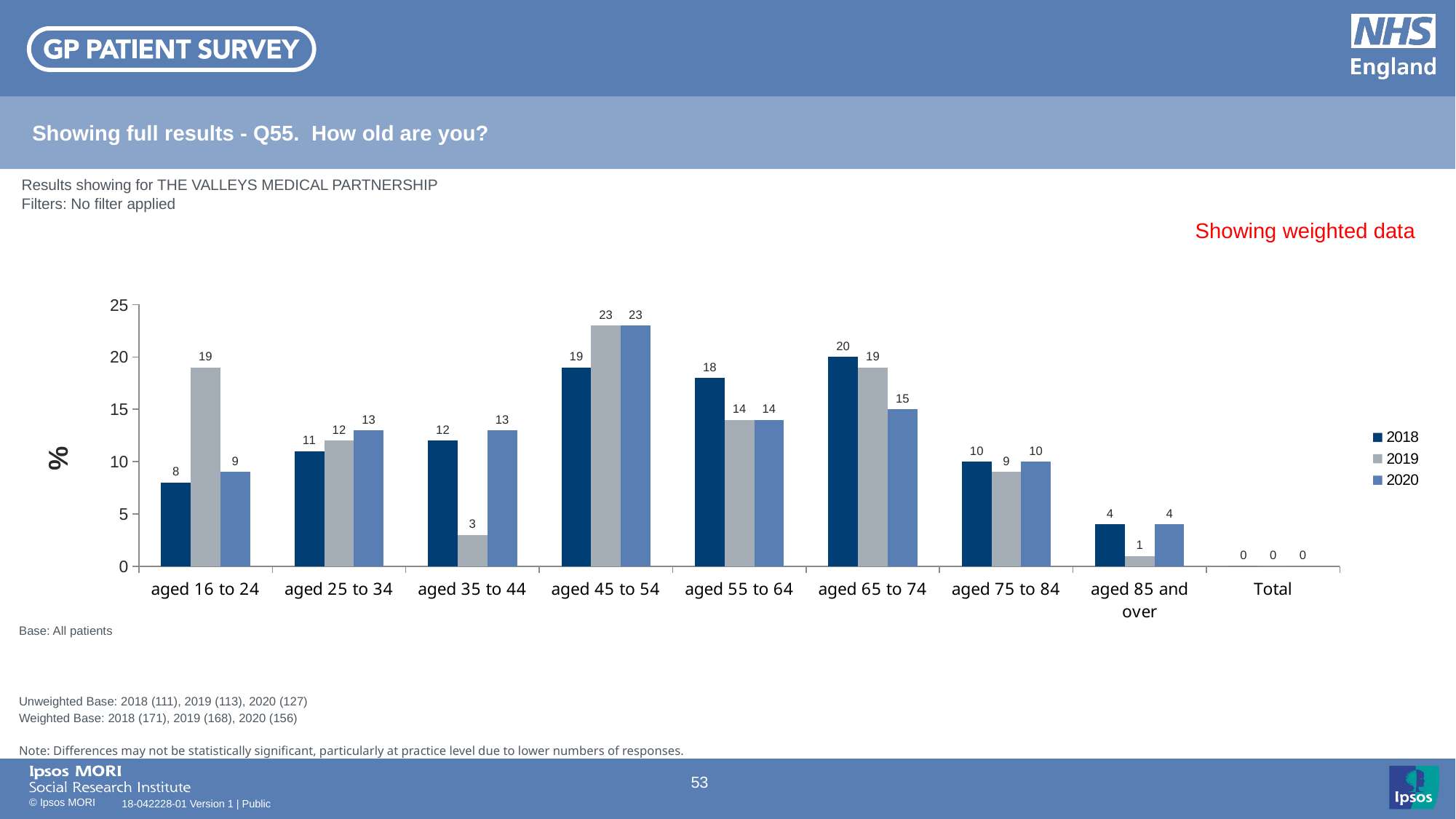
What is the label on the y axis? % Which age category has the lowest 2019 value, excluding Total? aged 85 and over Which is larger for aged 16 to 24: the 2018 value or the 2020 value? 2020 What is the 2019 value for aged 16 to 24? 19 What is the difference between the 2018 and 2019 values for aged 35 to 44? 9 What is the 2018 value for aged 55 to 64? 18 What kind of chart is shown on the slide? bar chart How many categories are shown on the x axis? 9 What is the 2018 value for aged 65 to 74? 20 What is the 2020 value for aged 65 to 74? 15 Which age category has the highest 2020 value? aged 45 to 54 How many series does the legend list? 3